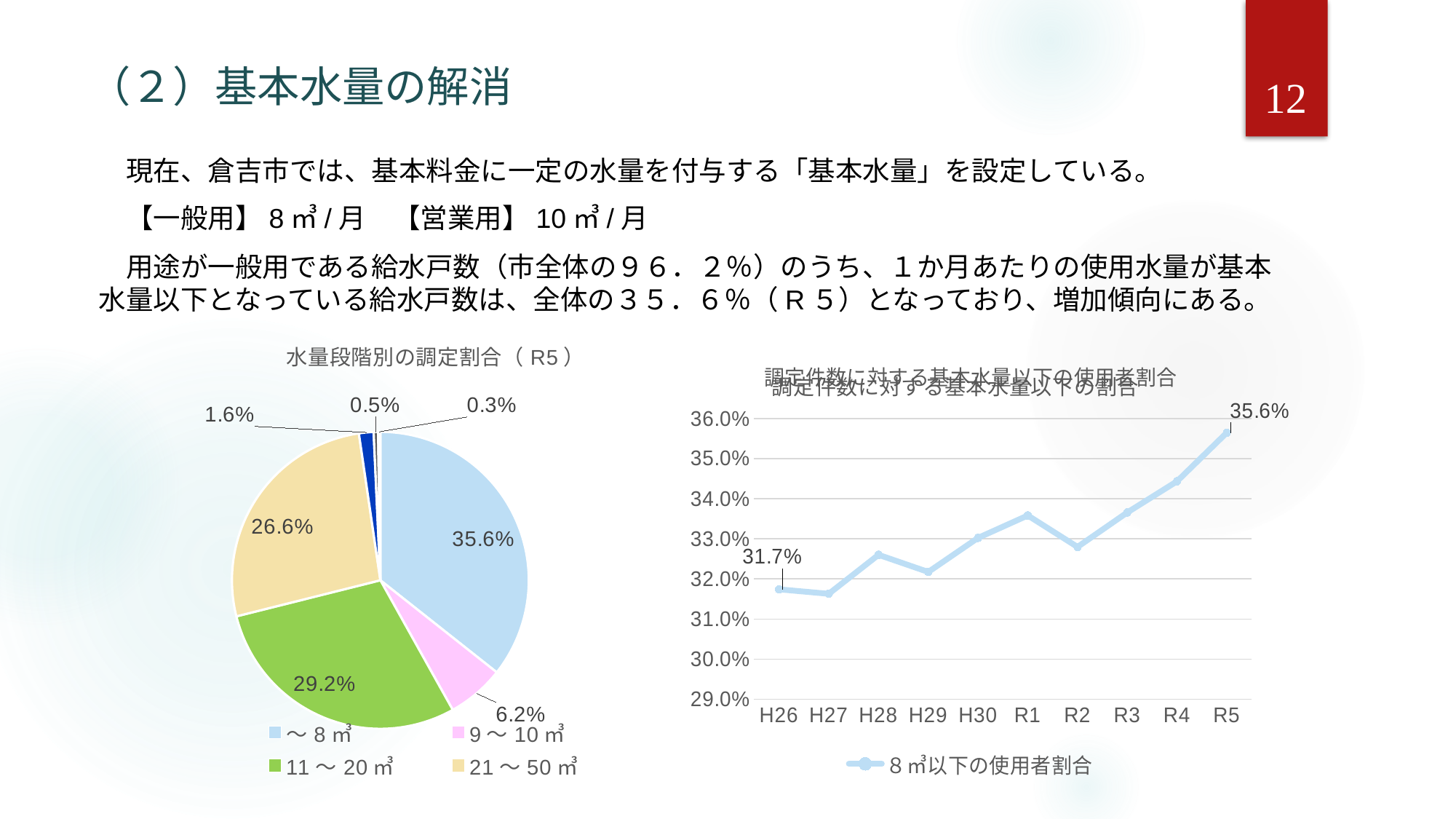
In the line chart on the right, what is the difference between the R5 value and the H26 value? 3.9% In the pie chart 水量段階別の調定割合（R5）, what share does the ～8㎥ slice have? 35.6% In the pie chart 水量段階別の調定割合（R5）, what share does the 9～10㎥ slice have? 6.2% In the line chart on the right, what is the value for R5? 35.6% In the pie chart 水量段階別の調定割合（R5）, what share does the 11～20㎥ slice have? 29.2% In the pie chart 水量段階別の調定割合（R5）, which legend category has the largest slice? ～8㎥ In the line chart on the right, what is the value for H26? 31.7% In the pie chart 水量段階別の調定割合（R5）, which is larger: the 21～50㎥ slice or the 11～20㎥ slice? 11～20㎥ In the line chart on the right, how many years are shown on the x axis? 10 In the pie chart 水量段階別の調定割合（R5）, what is the difference between the ～8㎥ slice and the 11～20㎥ slice? 6.4% In the pie chart 水量段階別の調定割合（R5）, what share does the 21～50㎥ slice have? 26.6% In the line chart on the right, is the value for R4 greater or less than 34.0%? greater